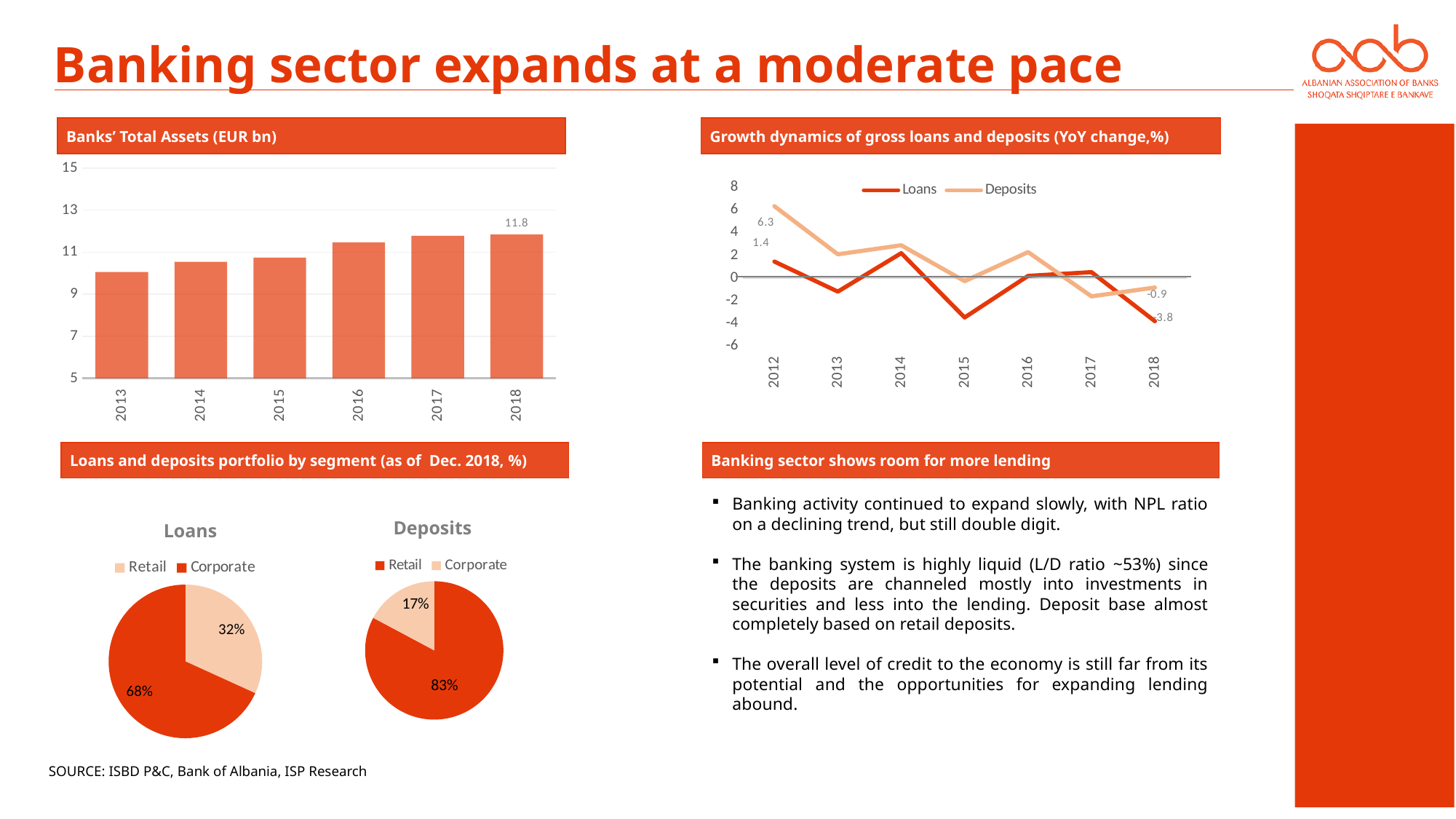
In the 'Growth dynamics of gross loans and deposits' chart, what is the value for Deposits in 2012? 6.3 How many years are shown in the 'Banks' Total Assets (EUR bn)' chart? 6 In the 'Banks' Total Assets (EUR bn)' chart, do the values rise or fall from 2013 to 2018? rise In the 'Growth dynamics of gross loans and deposits' chart, what is the value for Loans in 2018? -3.8 In the 'Banks' Total Assets (EUR bn)' chart, what is the value for 2018? 11.8 How many series does the legend of the 'Growth dynamics of gross loans and deposits' chart list? 2 In the 'Growth dynamics of gross loans and deposits' chart, what is the difference between the Deposits and Loans values in 2018? 2.9 In the 'Deposits' pie chart under 'Loans and deposits portfolio by segment', what share is Retail? 83% What kind of chart is the 'Banks' Total Assets (EUR bn)' chart? bar chart In the 'Banks' Total Assets (EUR bn)' chart, which year has the lowest total assets? 2013 In the 'Loans' pie chart under 'Loans and deposits portfolio by segment', what share is Corporate? 68% In the 'Banks' Total Assets (EUR bn)' chart, is the value for 2013 greater or less than 11? less